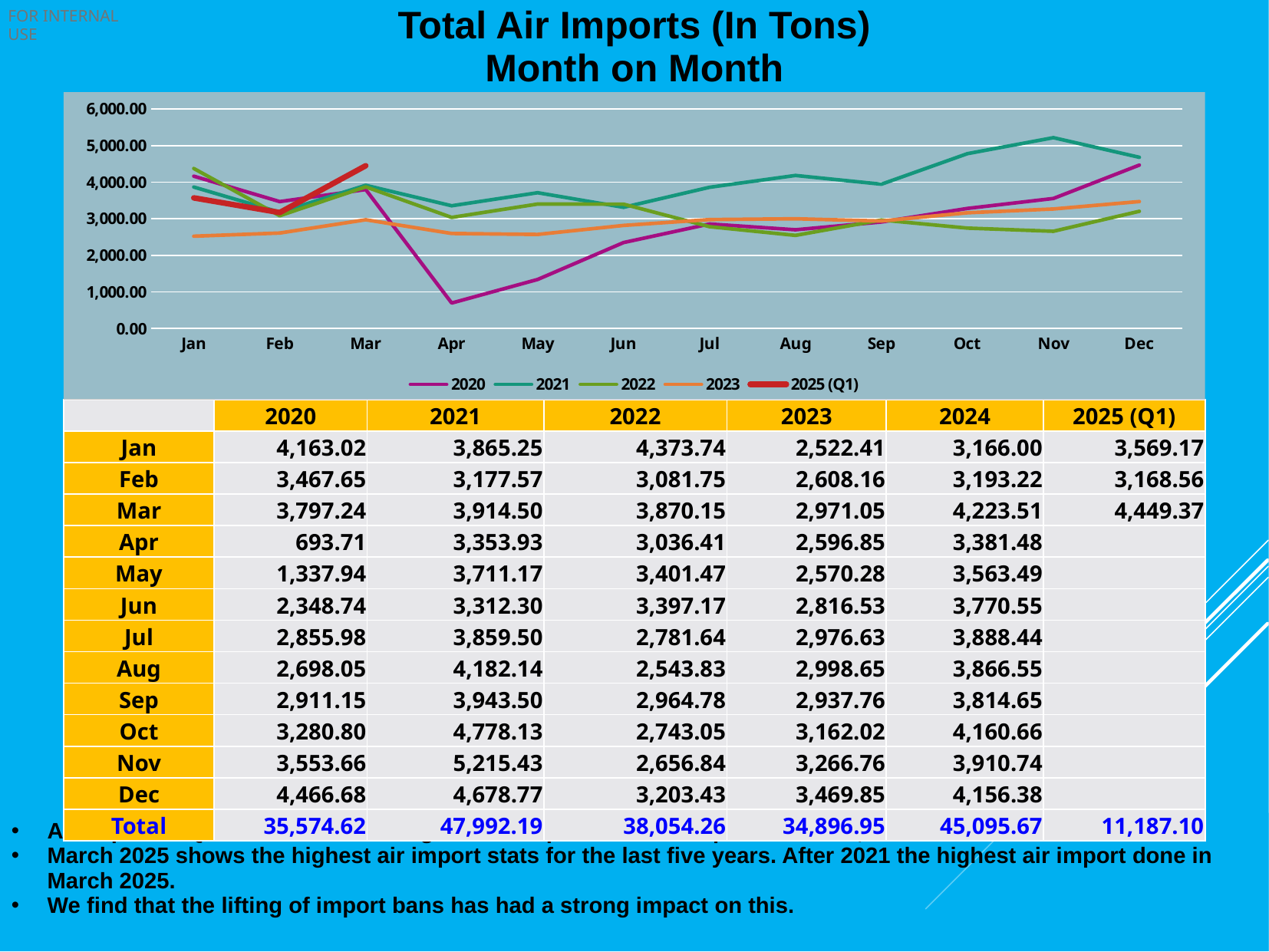
Does the 2020 series rise or fall from April to July? Rise What is the value for March in the 2025 (Q1) series? 4,449.37 In which month does the 2021 series reach its highest value? Nov What is the difference between the March and February values in the 2025 (Q1) series? 1,280.81 In which month does the 2020 series reach its lowest value? Apr How many series does the chart legend list? 5 Is the value for April in the 2020 series greater or less than 1,000.00? less What is the value for November in the 2021 series? 5,215.43 How many months are shown along the x axis of the chart? 12 Which series has the larger value in January, 2020 or 2021? 2020 What kind of chart is shown on the slide? Line chart What is the value for April in the 2020 series? 693.71